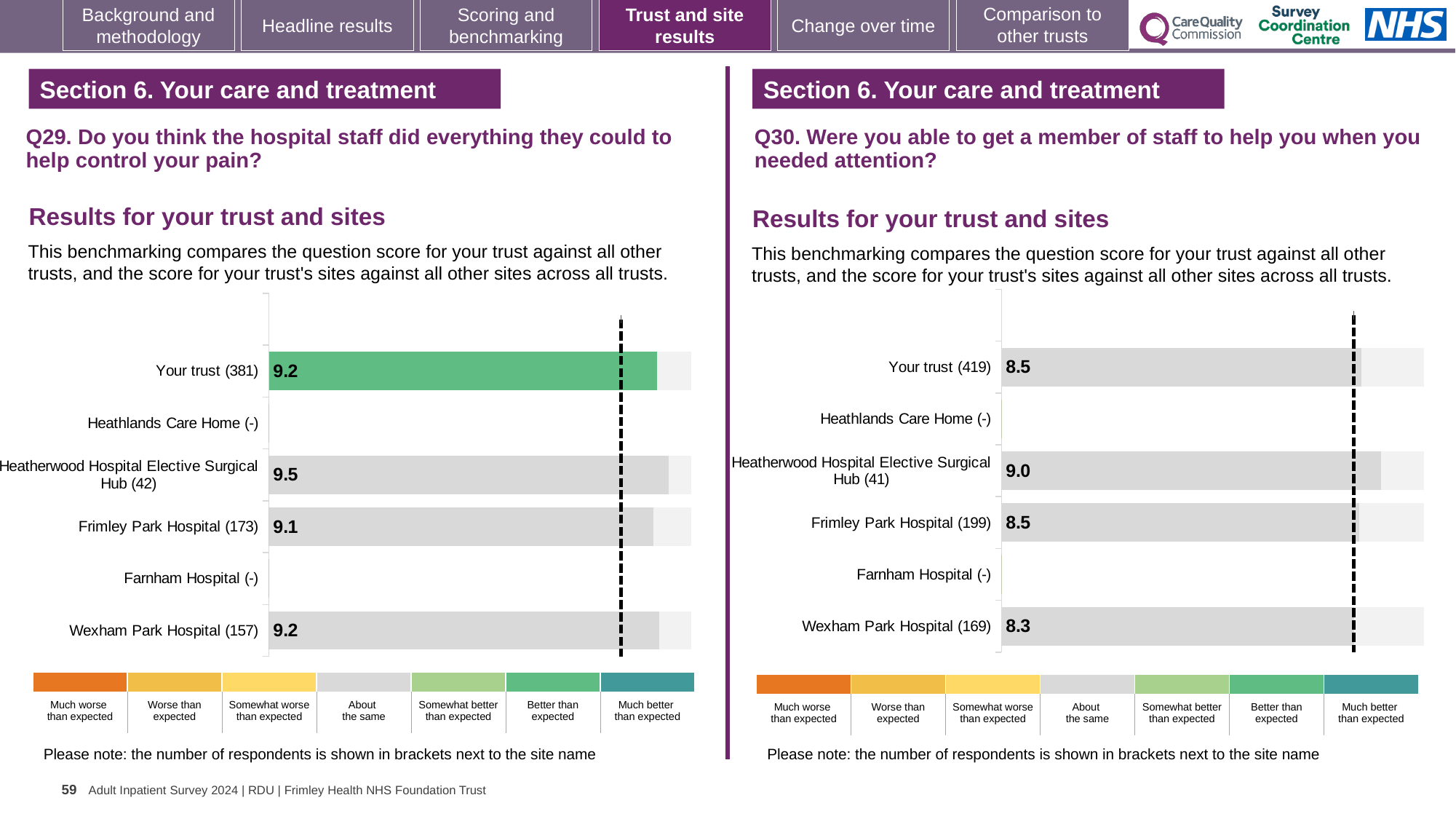
In the Q29 chart on the left, what is the score for Frimley Park Hospital? 9.1 In the Q29 chart on the left, how many respondents are shown in brackets for Your trust? 381 In the Q30 chart on the right, is the score for Heatherwood Hospital Elective Surgical Hub larger or smaller than the score for Frimley Park Hospital? larger In the Q29 chart on the left, what is the score for Heatherwood Hospital Elective Surgical Hub? 9.5 In the Q30 chart on the right, what is the score for Your trust? 8.5 In the Q30 chart on the right, what is the score for Wexham Park Hospital? 8.3 In the Q29 chart on the left, which site or trust row has the highest score? Heatherwood Hospital Elective Surgical Hub In the Q29 chart on the left, what is the difference between the scores for Heatherwood Hospital Elective Surgical Hub and Frimley Park Hospital? 0.4 In the Q30 chart on the right, what is the difference between the scores for Heatherwood Hospital Elective Surgical Hub and Wexham Park Hospital? 0.7 How many site or trust rows are listed in the Q29 chart on the left? 6 What kind of chart is used for the Q30 results on the right? bar chart In the Q30 chart on the right, which row has the lowest score among those with a value shown? Wexham Park Hospital